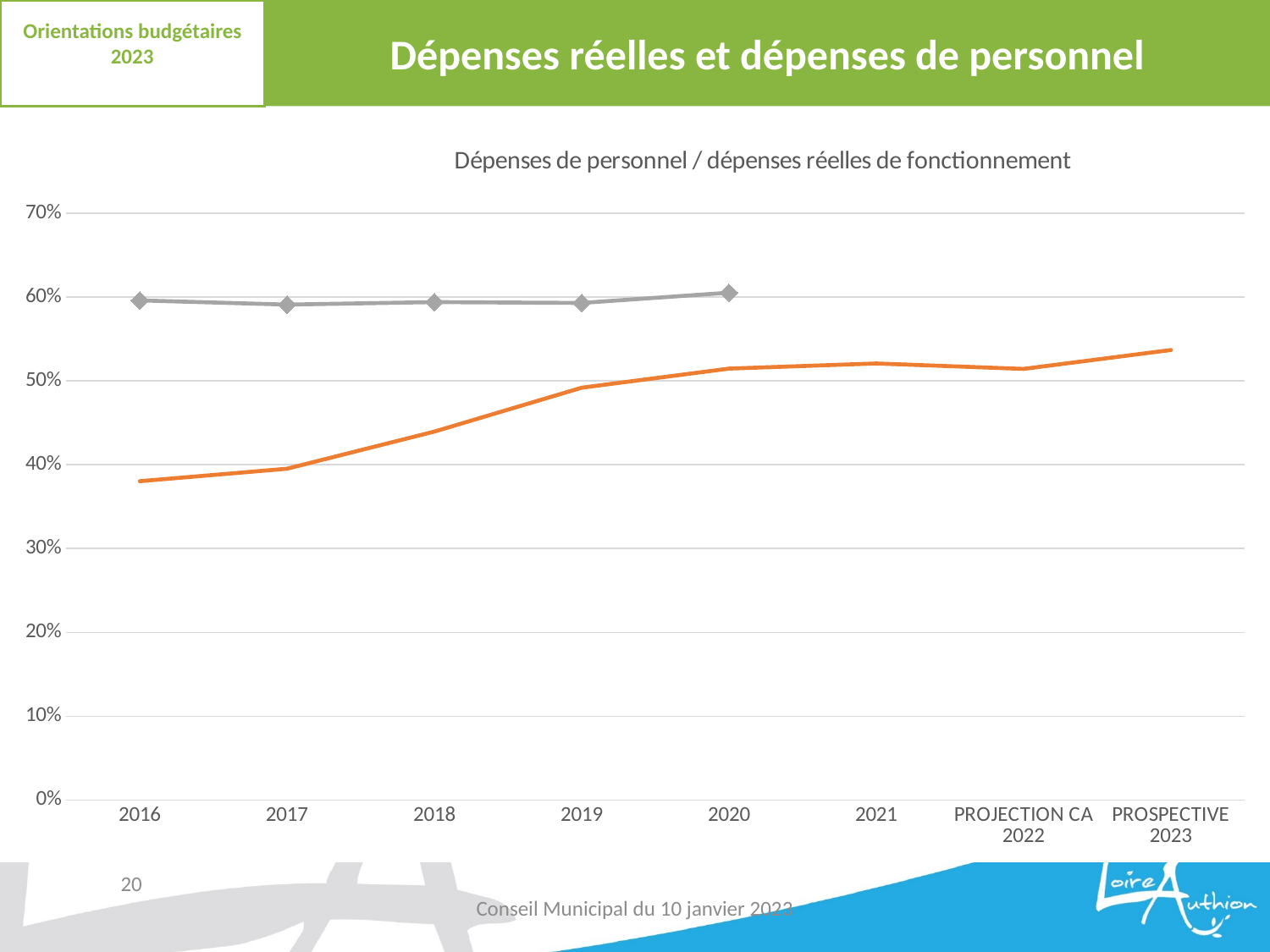
For which category does the orange line have its lowest value? 2016 In 2016, which line has the higher value, the grey line or the orange line? the grey line What is the title of the chart? Dépenses de personnel / dépenses réelles de fonctionnement Is the value of the grey line for 2018 greater or less than 50%? greater Does the orange line rise or fall from 2016 to 2020? rise Is the value of the grey line for 2020 greater or less than 70%? less What kind of chart is shown on the slide? line chart Is the value of the orange line for 2020 greater or less than 50%? greater For which category does the orange line reach its highest value? PROSPECTIVE 2023 How many categories are shown on the x axis of the chart? 8